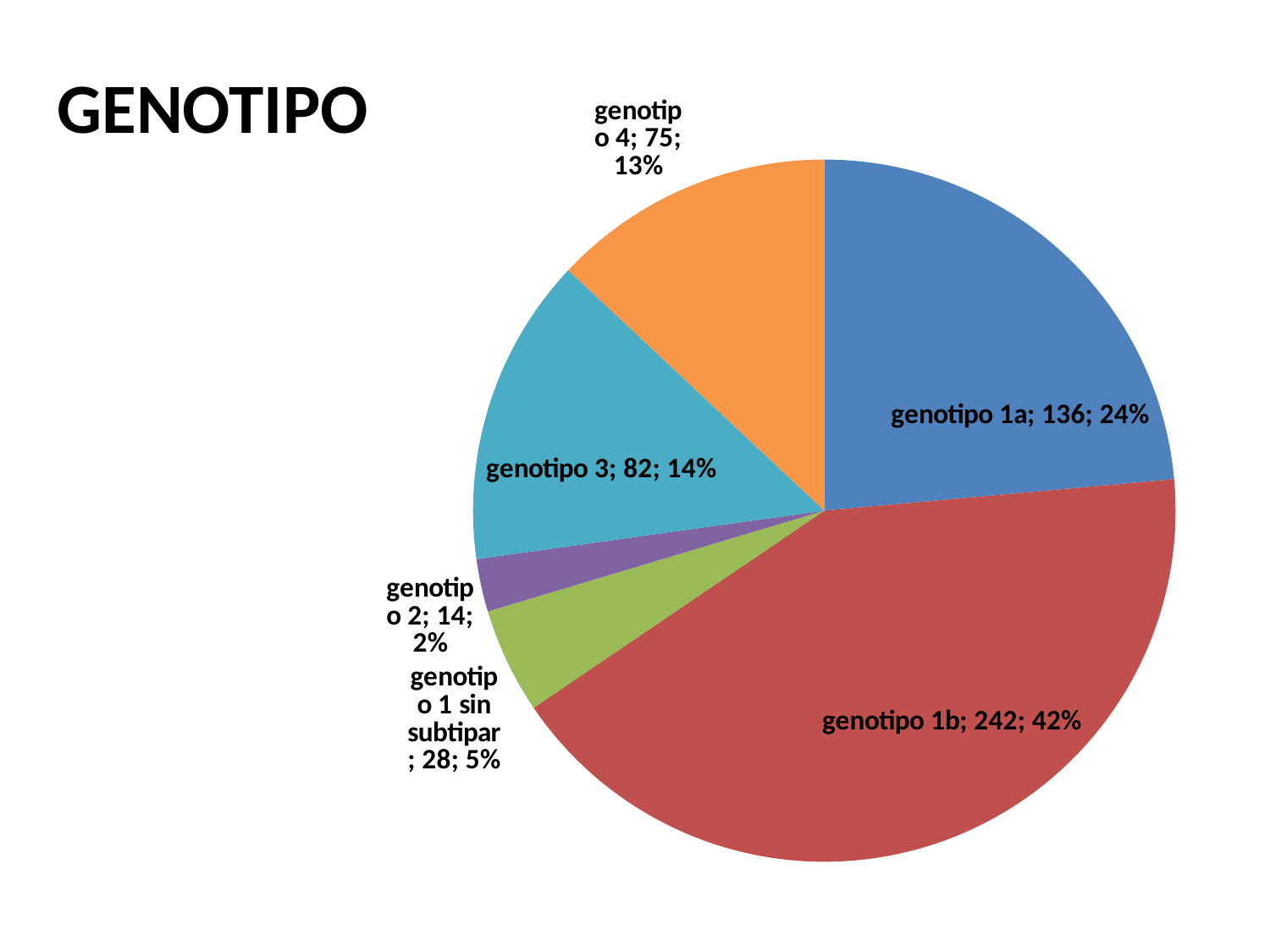
How many slices does the pie chart have? 6 What percentage share does genotipo 4 have? 13% Which genotype has the smallest slice? genotipo 2 What is the value for genotipo 1 sin subtipar? 28 What is the value for genotipo 3? 82 What kind of chart is shown on the slide? pie chart What is the title of the slide? GENOTIPO What is the value for genotipo 1b? 242 What is the difference between the values for genotipo 1b and genotipo 1a? 106 What percentage share does genotipo 1a have? 24% Which is larger, the value for genotipo 3 or genotipo 4? genotipo 3 Which genotype has the largest slice? genotipo 1b